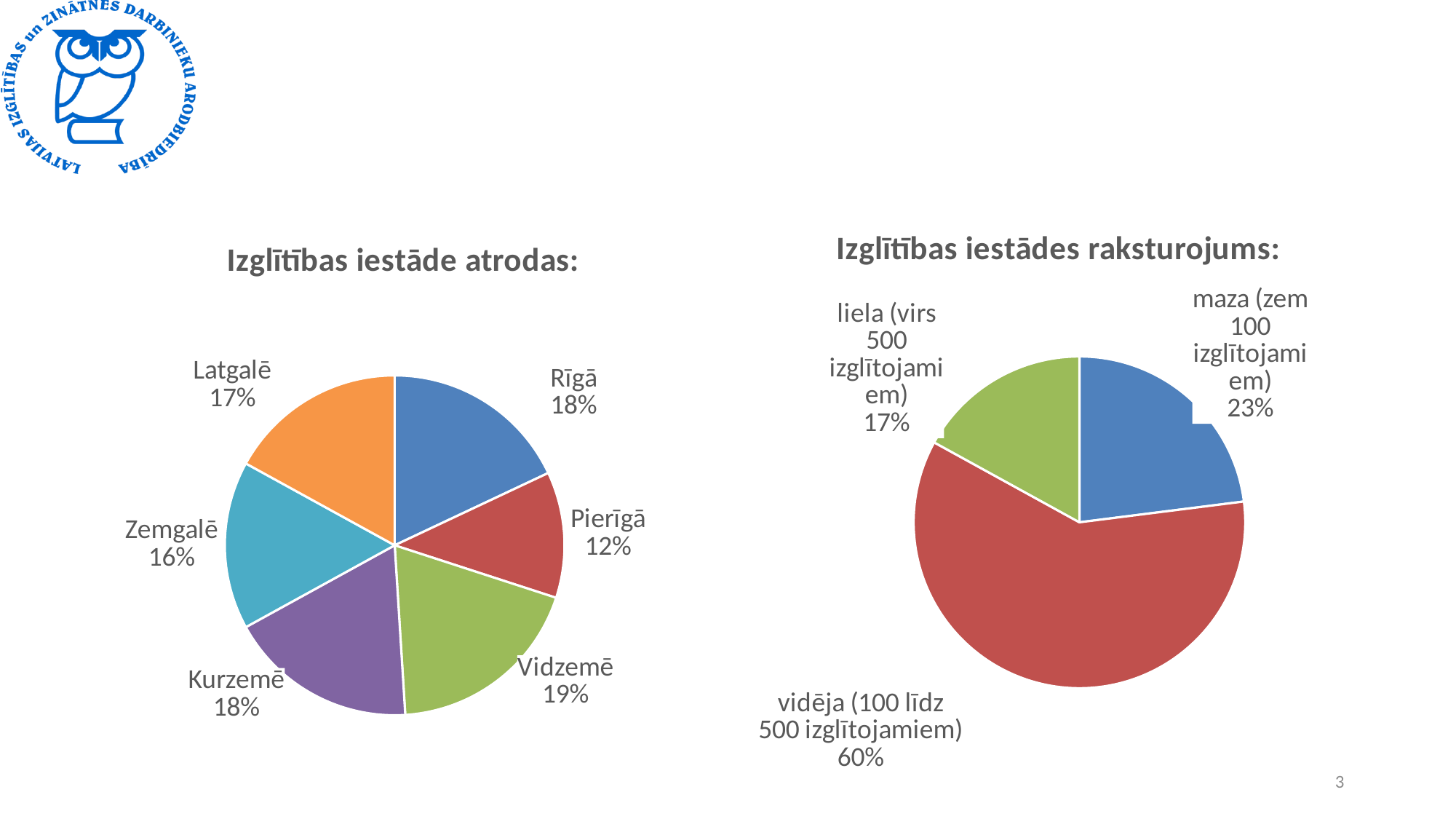
What kind of chart is the chart titled "Izglītības iestādes raksturojums:"? Pie chart In the chart titled "Izglītības iestāde atrodas:", what is the difference between the shares for Vidzemē and Pierīgā? 7% In the chart titled "Izglītības iestāde atrodas:", what share is shown for Rīgā? 18% In the chart titled "Izglītības iestādes raksturojums:", what share is shown for maza (zem 100 izglītojamiem)? 23% In the chart titled "Izglītības iestāde atrodas:", which region has the largest slice? Vidzemē In the chart titled "Izglītības iestāde atrodas:", which region has the smallest slice? Pierīgā In the chart titled "Izglītības iestādes raksturojums:", which category has the smallest slice? liela (virs 500 izglītojamiem) In the chart titled "Izglītības iestāde atrodas:", which is larger, the share for Latgalē or the share for Zemgalē? Latgalē In the chart titled "Izglītības iestādes raksturojums:", what is the difference between the shares for maza and liela institutions? 6% In the chart titled "Izglītības iestādes raksturojums:", what share is shown for vidēja (100 līdz 500 izglītojamiem)? 60% In the chart titled "Izglītības iestāde atrodas:", what share is shown for Pierīgā? 12% In the chart titled "Izglītības iestāde atrodas:", how many regions are shown? 6